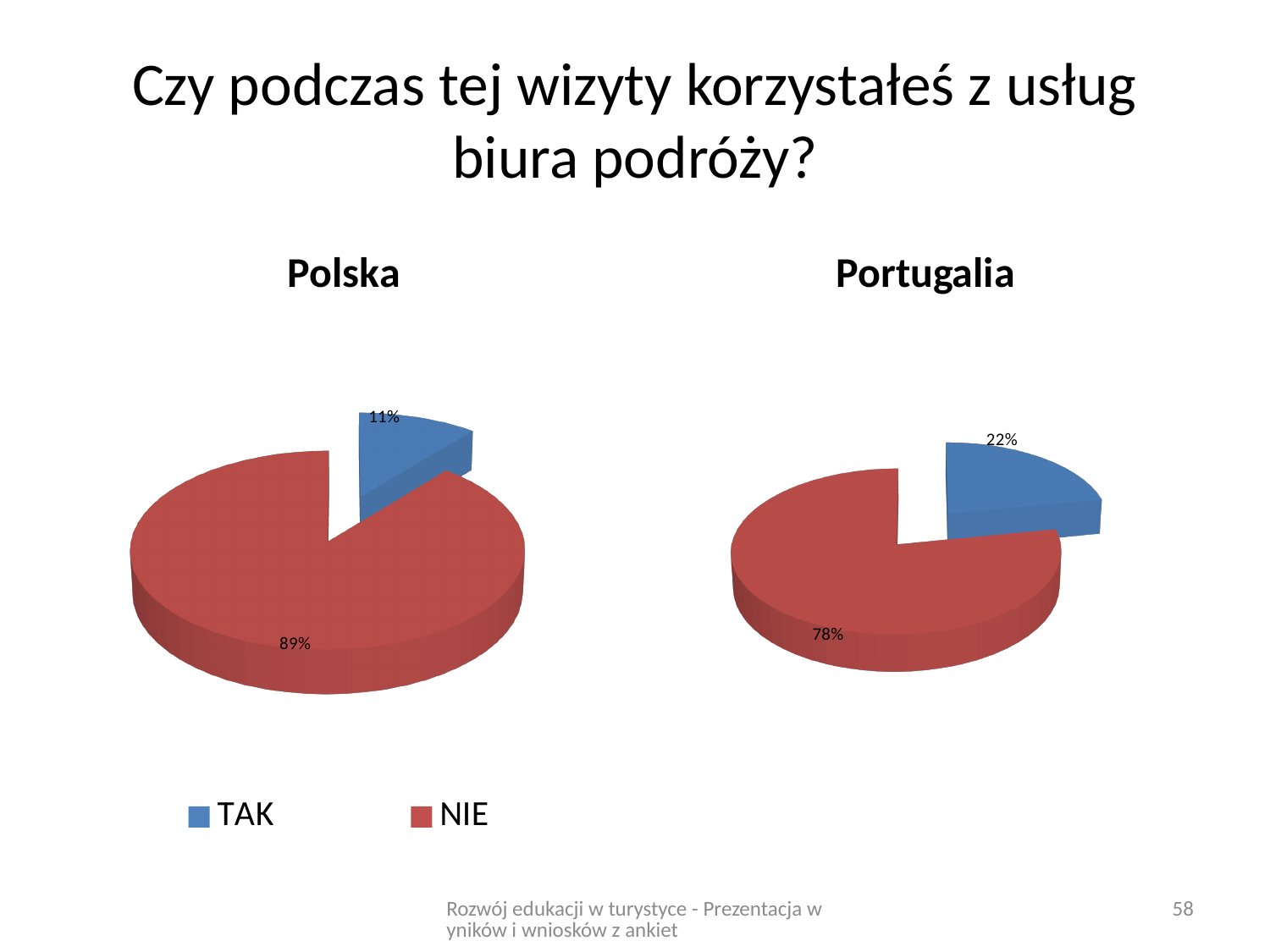
In the Portugalia chart, what share of respondents answered NIE? 78% In the Portugalia chart, which answer has the smallest slice? TAK What type of chart is used for the Polska data? Pie chart In the Polska chart, what share of respondents answered NIE? 89% Which chart shows a larger TAK share, Polska or Portugalia? Portugalia In the Polska chart, what share of respondents answered TAK? 11% How many slices does the Portugalia chart have? 2 Which colour represents NIE in the legend? Red What is the difference between the NIE and TAK shares in the Portugalia chart? 56% In the Portugalia chart, what share of respondents answered TAK? 22% In the Polska chart, which answer has the largest slice? NIE What is the difference between the NIE and TAK shares in the Polska chart? 78%